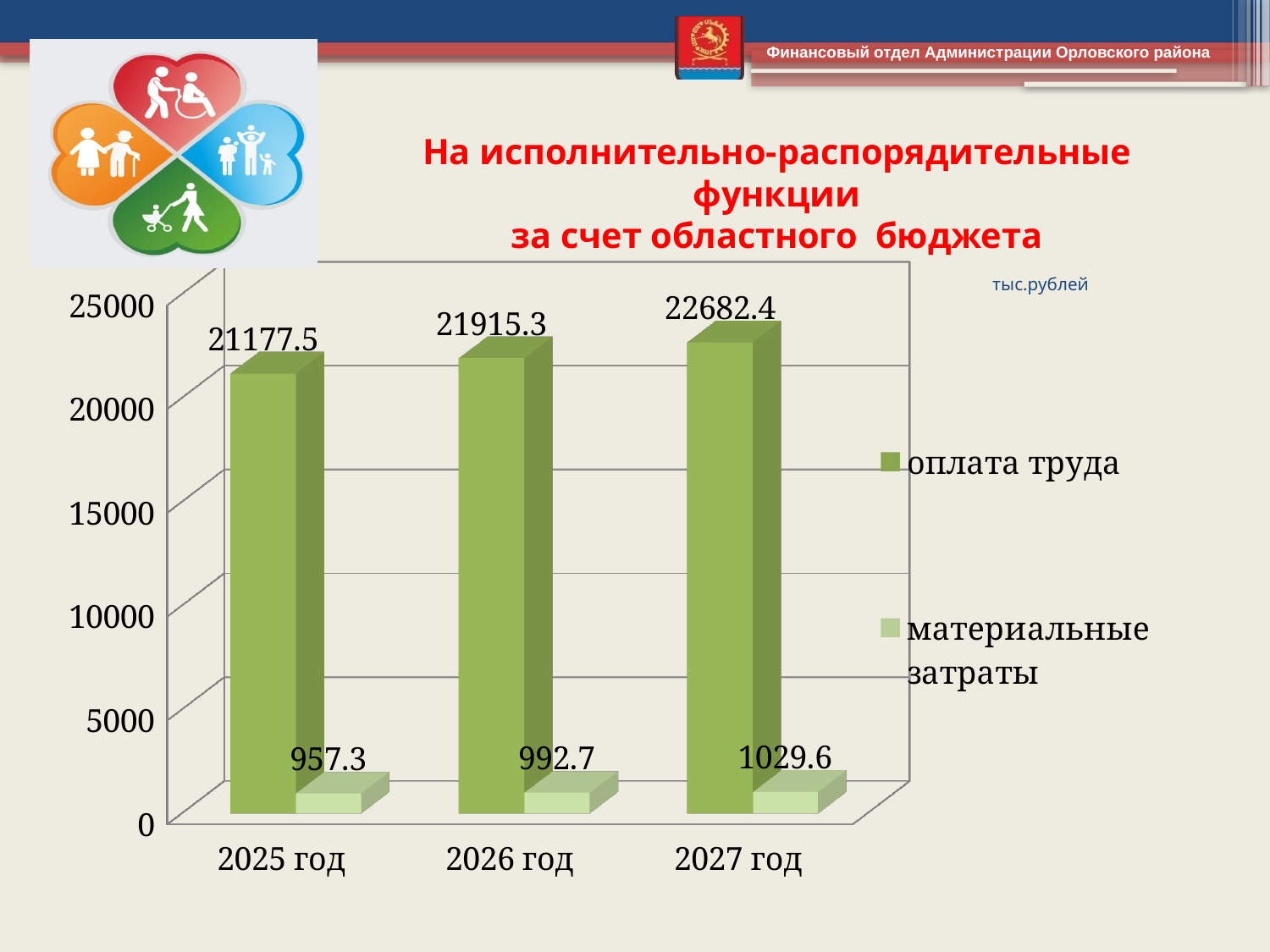
How many series does the legend list? 2 In which year is оплата труда highest? 2027 год What is the difference between оплата труда in 2027 год and 2026 год? 767.1 Does оплата труда rise or fall from 2025 год to 2027 год? rise What is the value for оплата труда in 2025 год? 21177.5 Which is larger: оплата труда in 2025 год or оплата труда in 2027 год? оплата труда in 2027 год What is the difference between материальные затраты in 2026 год and 2025 год? 35.4 What is the value for оплата труда in 2026 год? 21915.3 Is the value for оплата труда in 2027 год greater or less than 20000? greater In which year is материальные затраты lowest? 2025 год How many years are shown on the x axis? 3 What is the value for материальные затраты in 2027 год? 1029.6